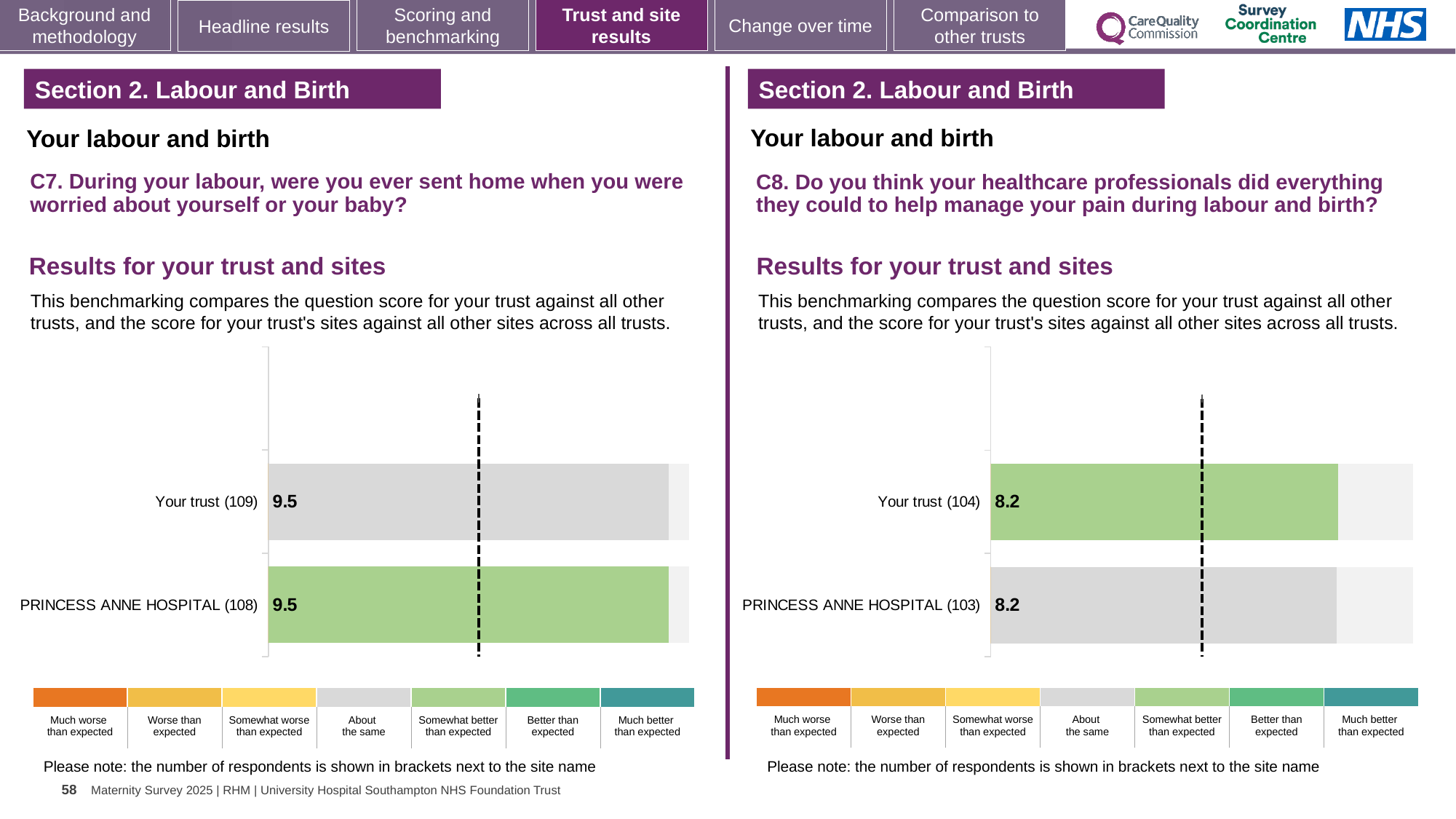
In the C7 chart on the left, how many respondents are shown in brackets for PRINCESS ANNE HOSPITAL? 108 How many bars are plotted in the C8 chart on the right? 2 In the C7 chart on the left, what is the difference between the score for Your trust and the score for PRINCESS ANNE HOSPITAL? 0.0 In the C8 chart on the right, what is the difference between the score for Your trust and the score for PRINCESS ANNE HOSPITAL? 0.0 In the C8 chart on the right, what is the score for PRINCESS ANNE HOSPITAL? 8.2 How many bars are plotted in the C7 chart on the left? 2 How many categories does the colour key below the C8 chart on the right list? 7 What kind of chart is used for the C7 results on the left? Bar chart In the C8 chart on the right, what is the score for Your trust? 8.2 In the C8 chart on the right, how many respondents are shown in brackets for Your trust? 104 In the C7 chart on the left, what is the score for PRINCESS ANNE HOSPITAL? 9.5 In the C7 chart on the left, what is the score for Your trust? 9.5